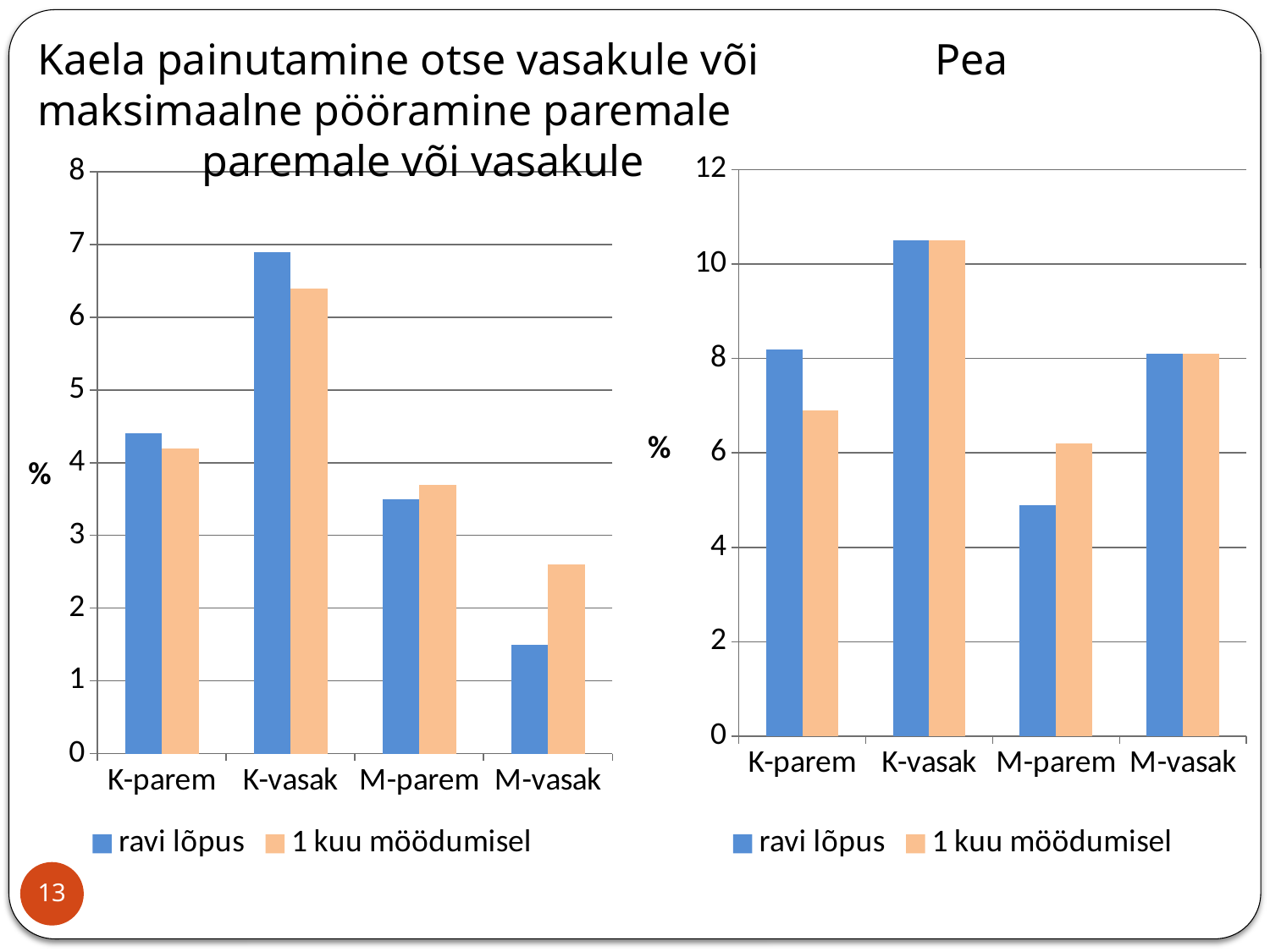
How many categories are shown on the x axis of the right chart titled "Pea"? 4 What are the two legend entries of the right chart titled "Pea"? ravi lõpus; 1 kuu möödumisel In the right chart titled "Pea", for K-parem, which series is larger: "ravi lõpus" or "1 kuu möödumisel"? ravi lõpus What kind of chart is the left chart on the slide? bar chart In the left chart, is the value for K-vasak "ravi lõpus" greater or less than 6? greater In the left chart, which category has the highest value for "ravi lõpus"? K-vasak In the right chart titled "Pea", which category has the highest value for "1 kuu möödumisel"? K-vasak In the right chart titled "Pea", which category has the lowest value for "ravi lõpus"? M-parem In the right chart titled "Pea", is the value for M-parem "ravi lõpus" greater or less than 6? less In the left chart, which category has the lowest value for "ravi lõpus"? M-vasak How many series does the legend of the left chart list? 2 In the left chart, for M-vasak, which series is larger: "ravi lõpus" or "1 kuu möödumisel"? 1 kuu möödumisel